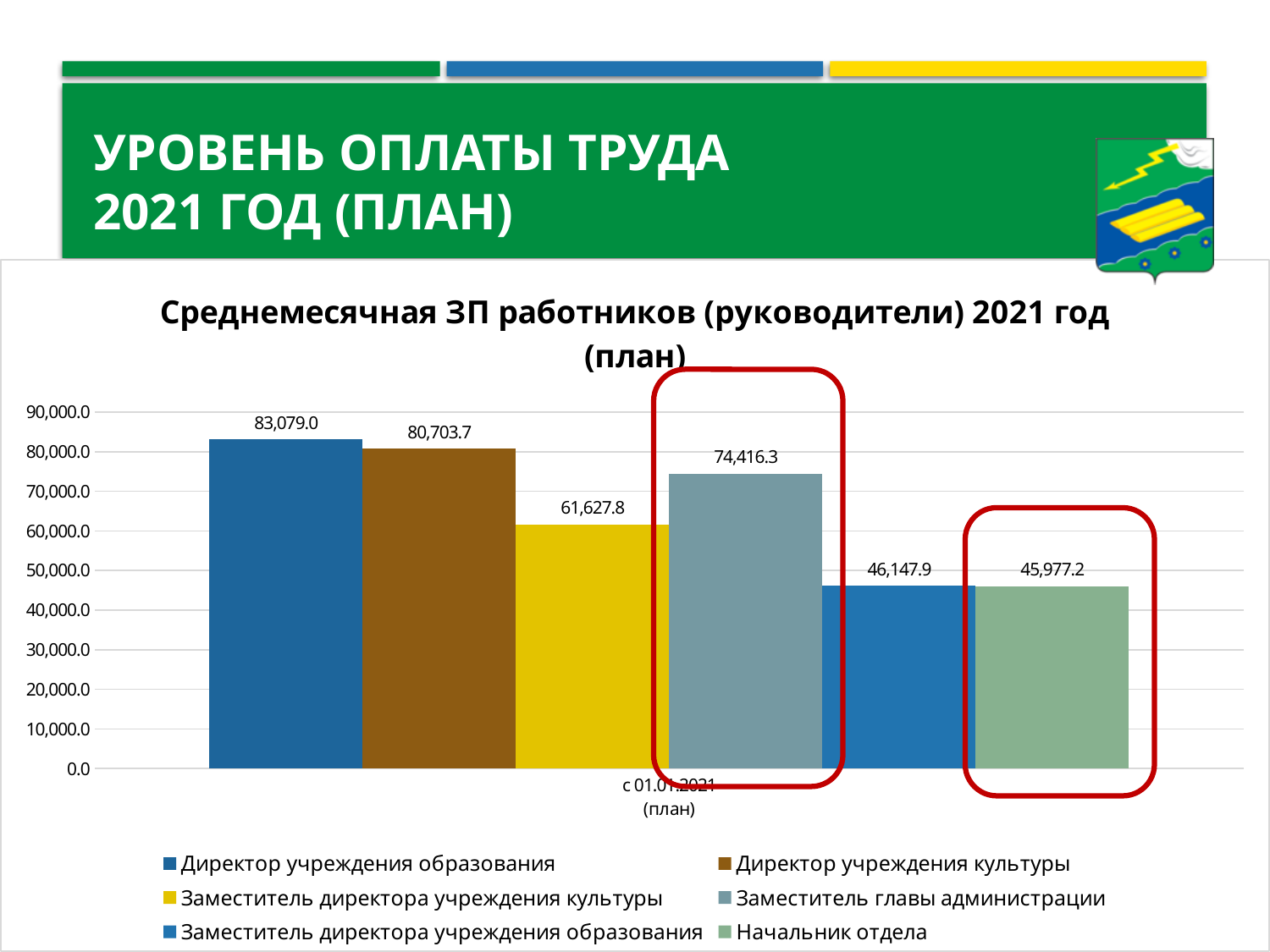
What value is shown for Заместитель главы администрации? 74,416.3 What is the difference between the values for Директор учреждения образования and Директор учреждения культуры? 2,375.3 What value is shown for Начальник отдела? 45,977.2 Is the value for Заместитель директора учреждения образования greater or less than 50,000.0? less What is the value for Заместитель директора учреждения культуры? 61,627.8 What kind of chart is shown on the slide? bar chart What is the planned average monthly salary for Директор учреждения образования? 83,079.0 How many series does the legend list? 6 Which position has the lowest planned average monthly salary? Начальник отдела Which position has the highest planned average monthly salary? Директор учреждения образования What is the difference between the values for Заместитель главы администрации and Заместитель директора учреждения культуры? 12,788.5 Which is larger: the value for Директор учреждения культуры or the value for Заместитель главы администрации? Директор учреждения культуры